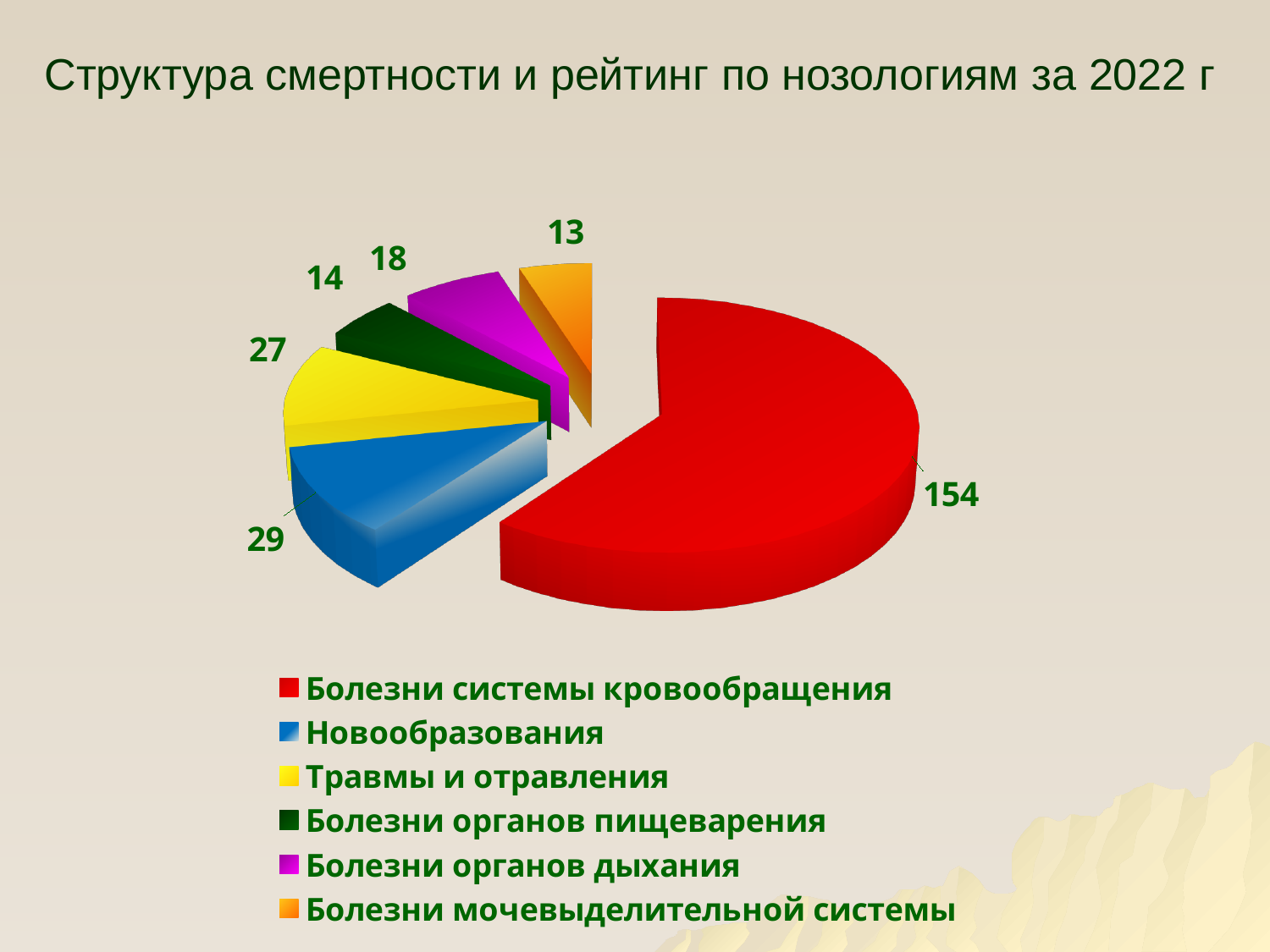
Which category has the highest value? Болезни системы кровообращения What is the difference between the values for Болезни системы кровообращения and Новообразования? 125 What is the value for Болезни мочевыделительной системы? 13 What is the value for Болезни органов дыхания? 18 What is the value for Новообразования? 29 Which category has the lowest value? Болезни мочевыделительной системы What is the total of all the values shown in the pie chart? 255 What colour is the slice for Болезни органов пищеварения? dark green What is the value for Болезни системы кровообращения? 154 What type of chart is shown on the slide? pie chart How many categories does the pie chart have? 6 Which is larger, the value for Травмы и отравления or the value for Болезни органов пищеварения? Травмы и отравления